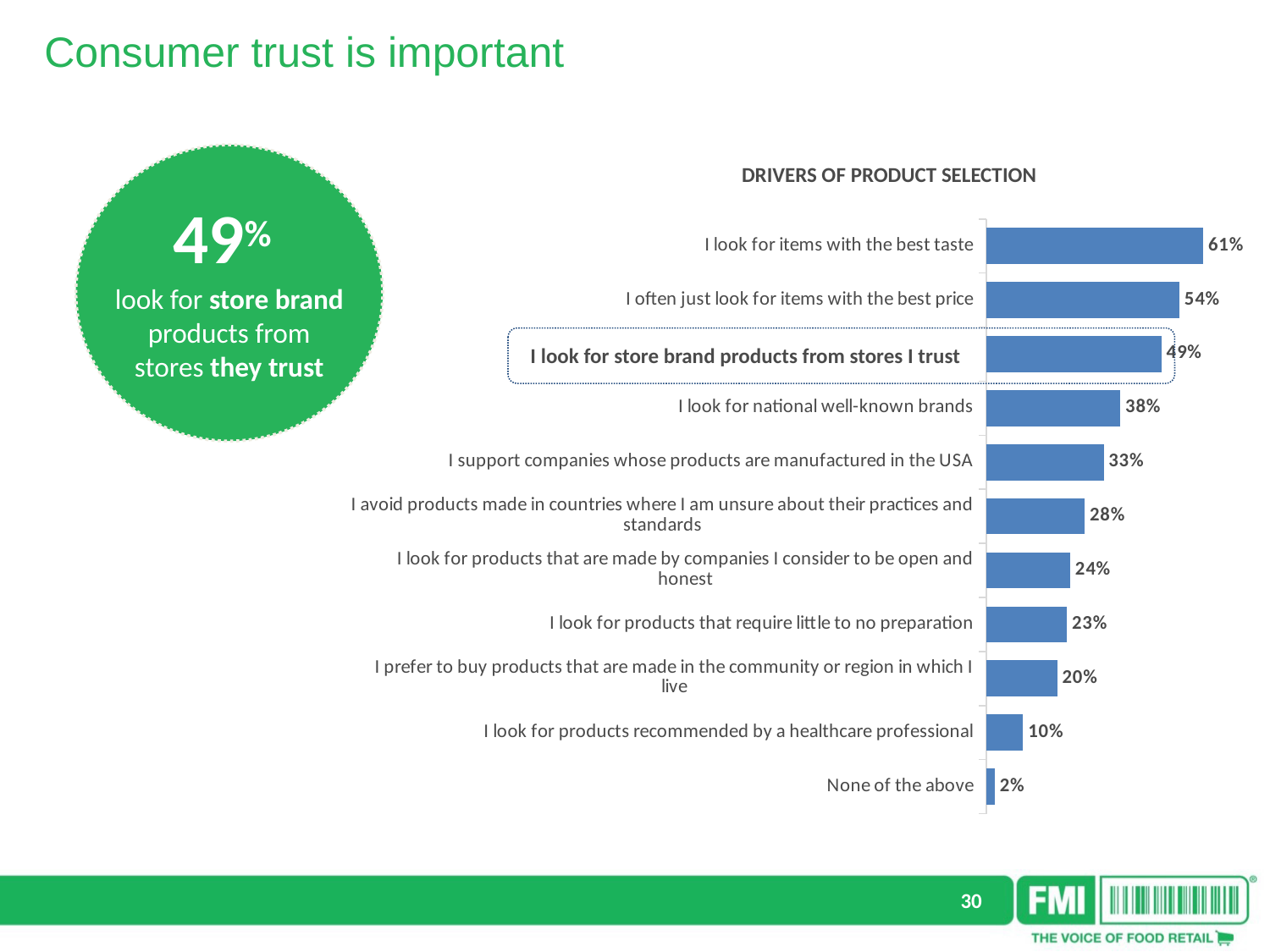
Which is larger: the value for national well-known brands or the value for supporting companies whose products are manufactured in the USA? I look for national well-known brands What is the value for "I look for store brand products from stores I trust"? 49% Which category has the lowest value in the chart? None of the above What kind of chart is shown on the slide? Bar chart How many categories are shown in the chart? 11 Which driver of product selection has the highest value? I look for items with the best taste Which category on the chart is highlighted with a dashed outline? I look for store brand products from stores I trust What is the difference between the value for items with the best taste and the value for items with the best price? 7% What is the difference between the value for products that require little to no preparation and the value for products made in the community or region in which I live? 3% What percentage look for products recommended by a healthcare professional? 10% What percentage of respondents say they look for items with the best taste? 61% What is the title of the chart? DRIVERS OF PRODUCT SELECTION